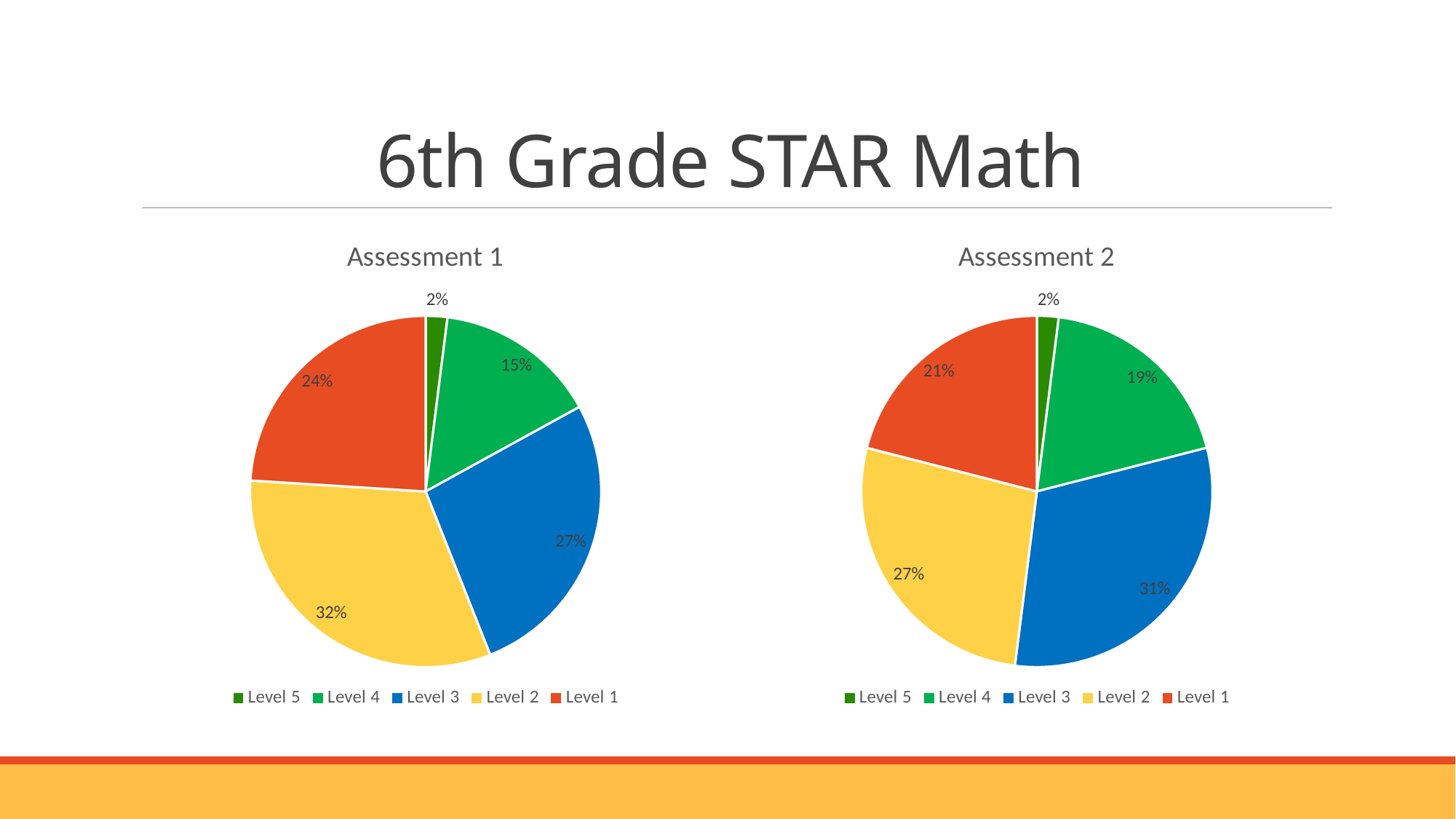
In the Assessment 2 chart, which is larger, Level 2 or Level 1? Level 2 What colour represents Level 3 in the legend of the Assessment 1 chart? Blue In the Assessment 1 chart, what percentage is shown for Level 4? 15% In the Assessment 1 chart, which level has the largest share? Level 2 In the Assessment 2 chart, what percentage is shown for Level 1? 21% In the Assessment 2 chart, what is the difference between the Level 3 and Level 4 percentages? 12% How many slices does the Assessment 1 pie chart have? 5 In the Assessment 1 chart, what percentage is shown for Level 2? 32% In the Assessment 2 chart, which level has the smallest share? Level 5 In the Assessment 1 chart, what is the difference between the Level 2 and Level 1 percentages? 8% In the Assessment 2 chart, what percentage is shown for Level 3? 31% What type of chart is used for Assessment 2? Pie chart